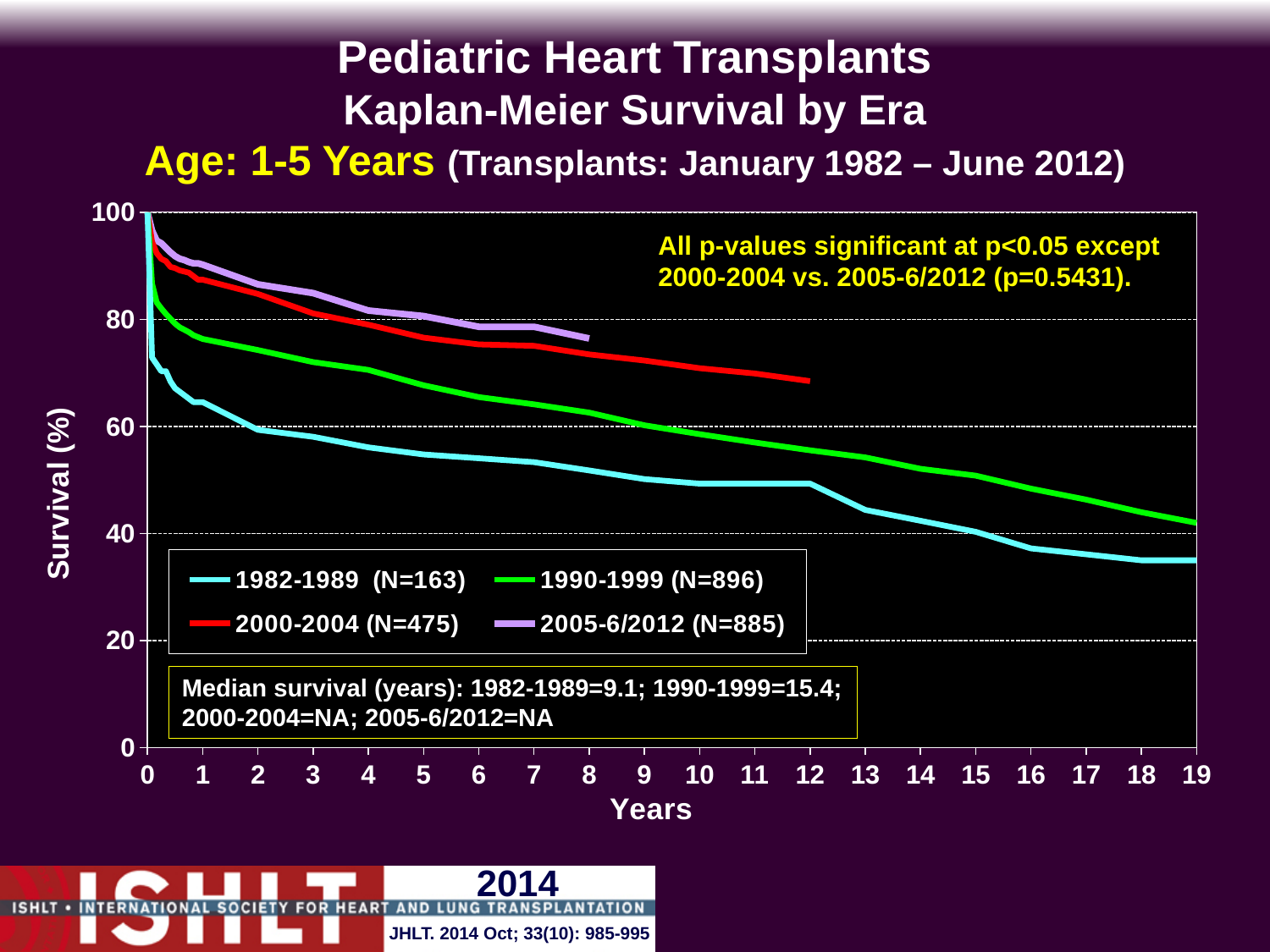
Which era has the lowest survival curve across the chart? 1982-1989 Is the survival for the 2000-2004 era at 12 years greater or less than 60? greater What is the median survival in years for the 1990-1999 era? 15.4 Is the survival for the 1982-1989 era at 10 years greater or less than 60? less What is the N for the 1982-1989 era shown in the legend? 163 At 10 years, which era has higher survival, 2000-2004 or 1990-1999? 2000-2004 What is the label of the x axis? Years How many series (eras) does the legend list? 4 Do the survival curves rise or fall as years increase? fall What kind of chart is shown on the slide? line chart Is the survival for the 1990-1999 era at 5 years greater or less than 60? greater Which era has the highest survival curve over the years it covers? 2005-6/2012